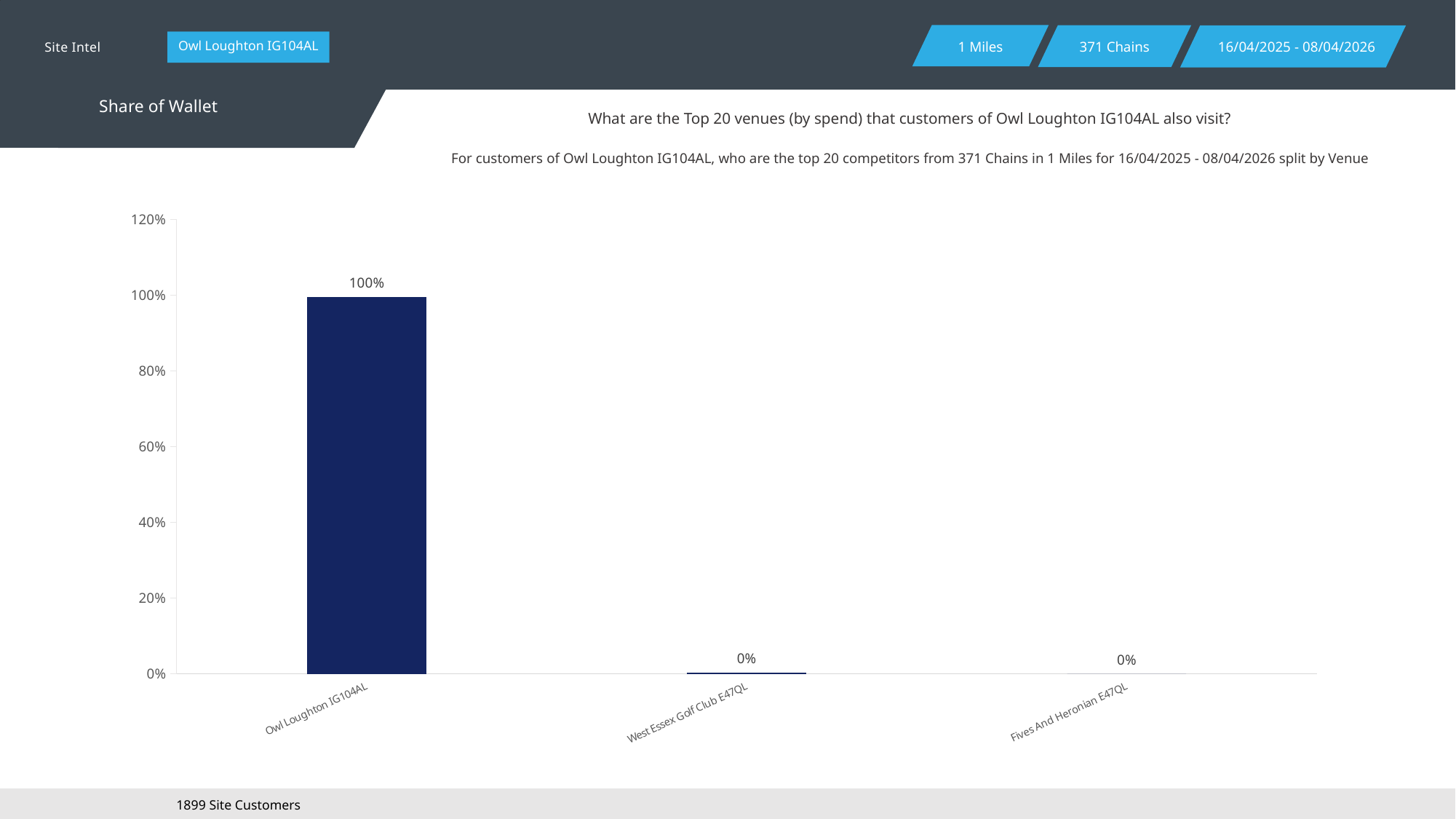
Is the value for Owl Loughton IG104AL greater or less than 80%? greater Is the value for West Essex Golf Club E47QL greater or less than 20%? less What kind of chart is shown? bar chart Which venue has the highest value? Owl Loughton IG104AL Do the values rise or fall from left to right along the x axis? fall How many venues are shown on the x axis? 3 Which is larger, the value for Owl Loughton IG104AL or the value for Fives And Heronian E47QL? Owl Loughton IG104AL What is the value for Owl Loughton IG104AL? 100% What is the value for Fives And Heronian E47QL? 0% What is the value for West Essex Golf Club E47QL? 0% What is the highest tick value shown on the y axis? 120% What is the difference between the values for Owl Loughton IG104AL and West Essex Golf Club E47QL? 100%